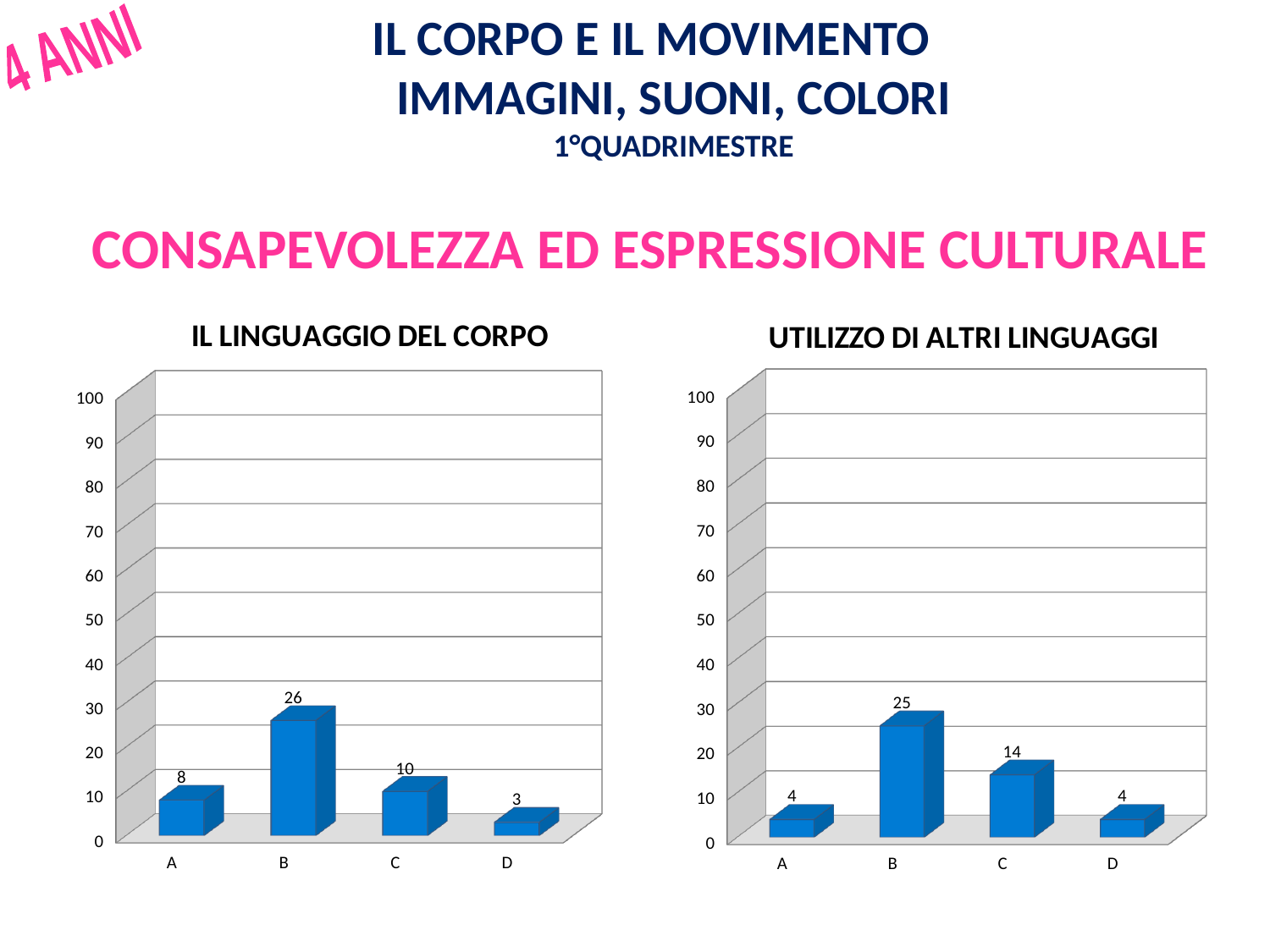
In the chart titled UTILIZZO DI ALTRI LINGUAGGI, what is the value for category C? 14 In the chart titled IL LINGUAGGIO DEL CORPO, which category has the lowest value? D What kind of chart is the chart titled UTILIZZO DI ALTRI LINGUAGGI? bar chart In the chart titled UTILIZZO DI ALTRI LINGUAGGI, which category has the highest value? B In the chart titled UTILIZZO DI ALTRI LINGUAGGI, is the value for B greater or less than 20? greater In the chart titled IL LINGUAGGIO DEL CORPO, which is larger, the value for A or the value for C? C In the chart titled IL LINGUAGGIO DEL CORPO, what is the value for category B? 26 What is the title of the chart on the left side of the slide? IL LINGUAGGIO DEL CORPO In the chart titled UTILIZZO DI ALTRI LINGUAGGI, what is the difference between the values for B and A? 21 In the chart titled IL LINGUAGGIO DEL CORPO, what is the difference between the values for B and C? 16 How many categories are shown in the chart titled IL LINGUAGGIO DEL CORPO? 4 In the chart titled UTILIZZO DI ALTRI LINGUAGGI, what is the value for category D? 4